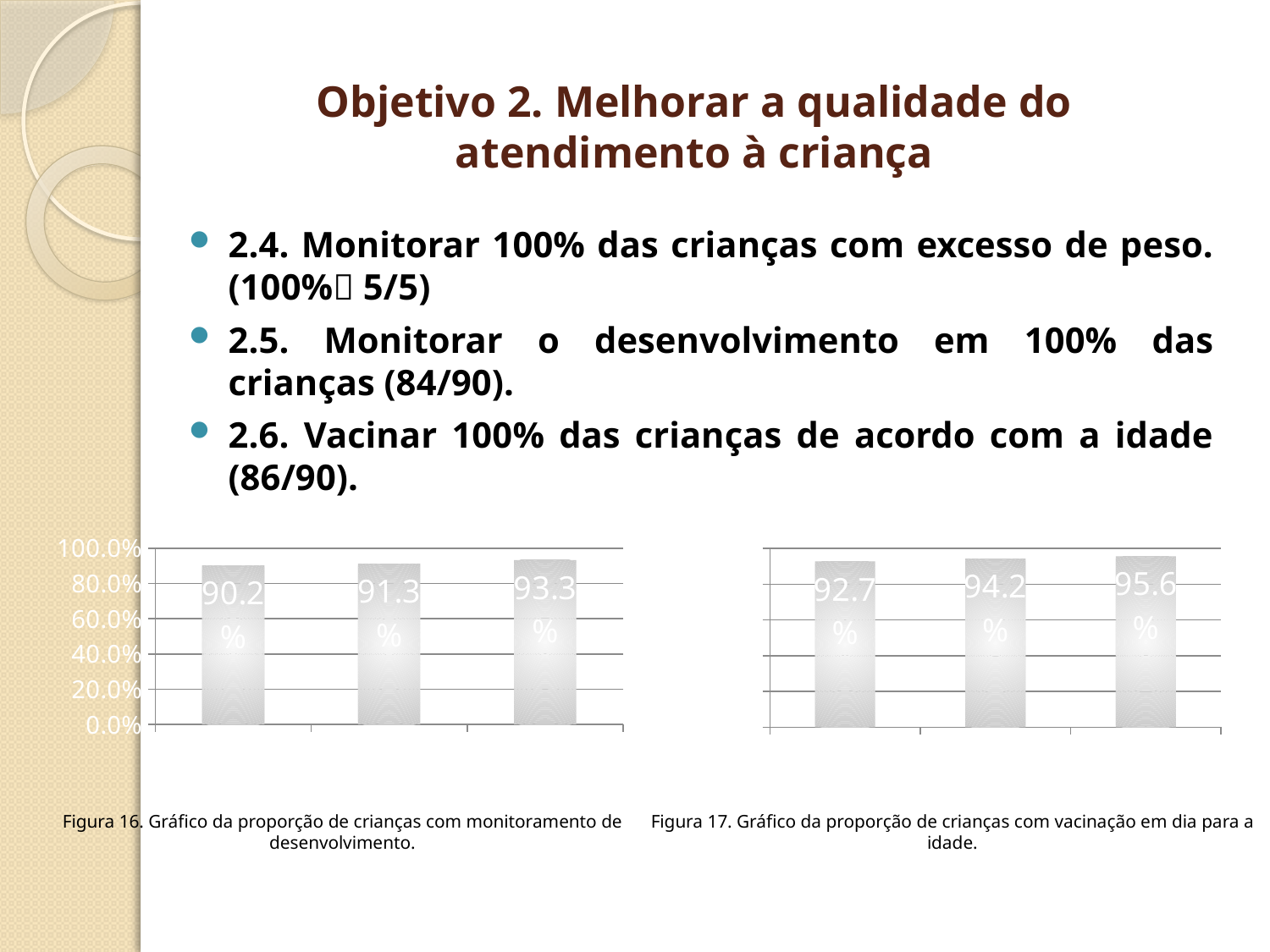
What type of chart is Figura 17? Bar chart How many bars are plotted in the left chart (Figura 16)? 3 In the right chart (Figura 17), what is the value of the third bar? 95.6% Which is larger: the second bar in the left chart (Figura 16) or the second bar in the right chart (Figura 17)? The second bar in the right chart (94.2%) In the left chart (Figura 16), what is the value of the third bar? 93.3% In the left chart (Figura 16), what is the value of the first bar? 90.2% In the right chart (Figura 17), which bar has the lowest value? The first bar (92.7%) In the right chart (Figura 17), what is the difference between the third bar and the first bar? 2.9% In the right chart (Figura 17), what is the value of the second bar? 94.2% In the left chart (Figura 16), which bar has the highest value? The third bar (93.3%) In the left chart (Figura 16), what is the difference between the third bar and the first bar? 3.1% In the right chart (Figura 17), do the values rise or fall from left to right? Rise